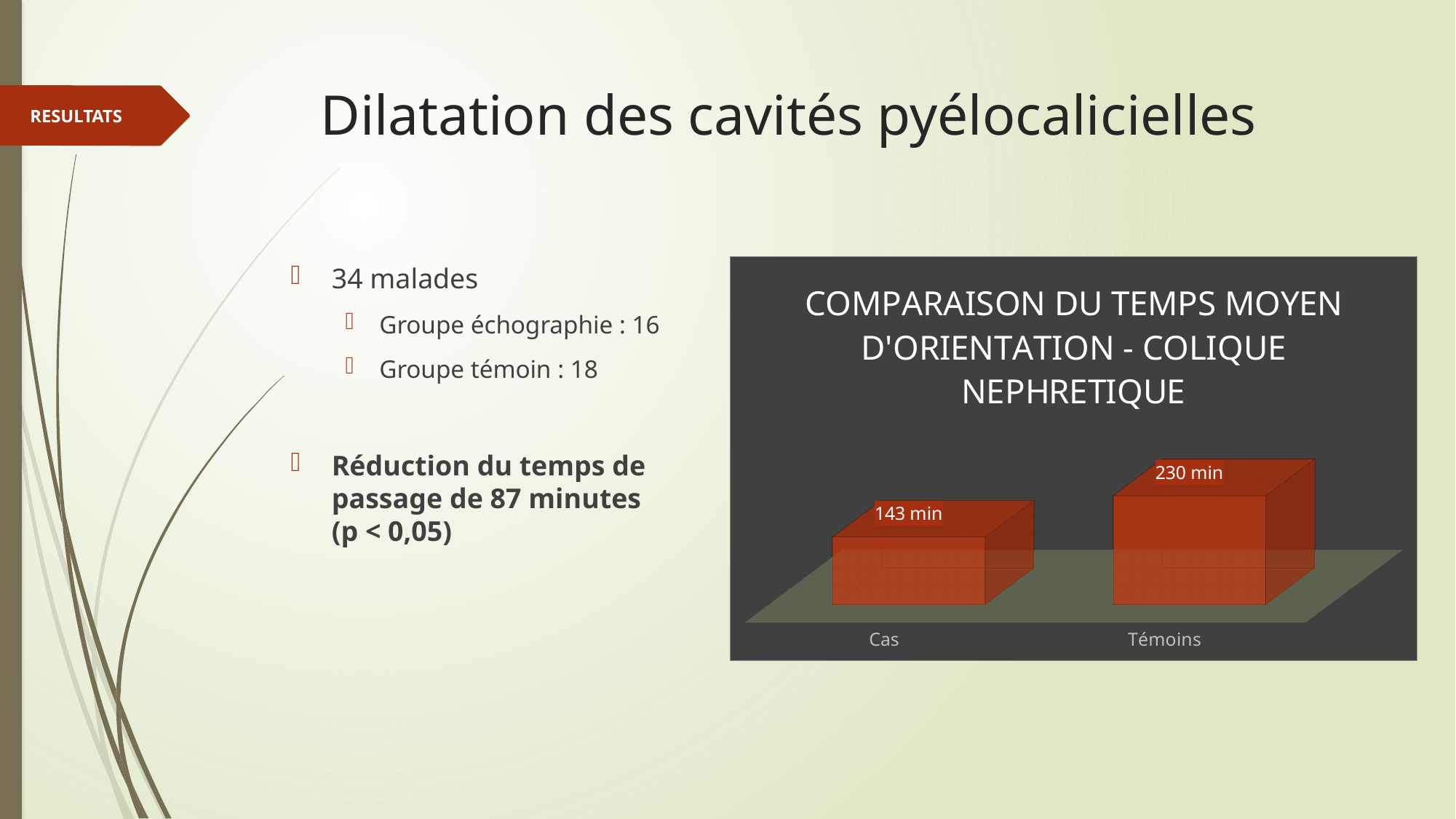
Which category has the highest value? Témoins What is the value for Témoins? 230 min How many categories are shown on the chart? 2 What is the value for Cas? 143 min Which category has the lowest value? Cas Do the values rise or fall from Cas to Témoins? Rise What is the difference between the values for Témoins and Cas? 87 min Which is larger, the value for Cas or the value for Témoins? Témoins What is the title of the chart? COMPARAISON DU TEMPS MOYEN D'ORIENTATION - COLIQUE NEPHRETIQUE What kind of chart is shown on the slide? Bar chart What colour are the bars in the chart? Red